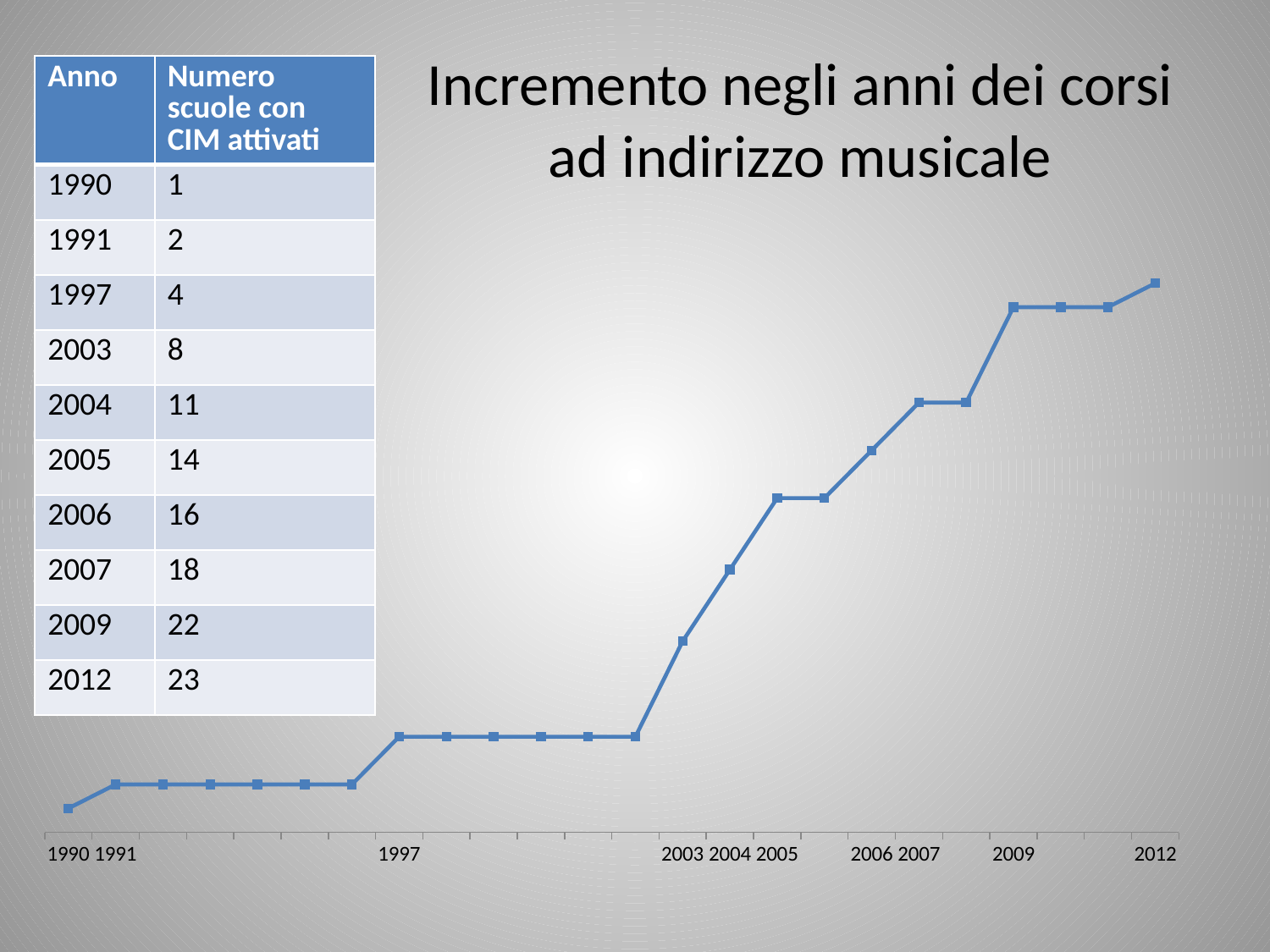
Which year has the highest value in the chart? 2012 Which year has the lowest value in the chart? 1990 Using the values in the table, what is the difference between the values for 2012 and 2009? 1 How many years are labelled on the x axis of the chart? 10 Do the values in the chart generally rise or fall from 1990 to 2012? rise According to the table on the slide, how many schools with CIM were active in 2005? 14 According to the table on the slide, what is the value for 2012? 23 According to the table on the slide, what is the value for 1997? 4 Is the value for 2009 higher or lower than the value for 2007? higher Is the value for 1997 higher or lower than the value for 2003? lower What kind of chart is shown on the slide? line chart What is the title of the chart? Incremento negli anni dei corsi ad indirizzo musicale